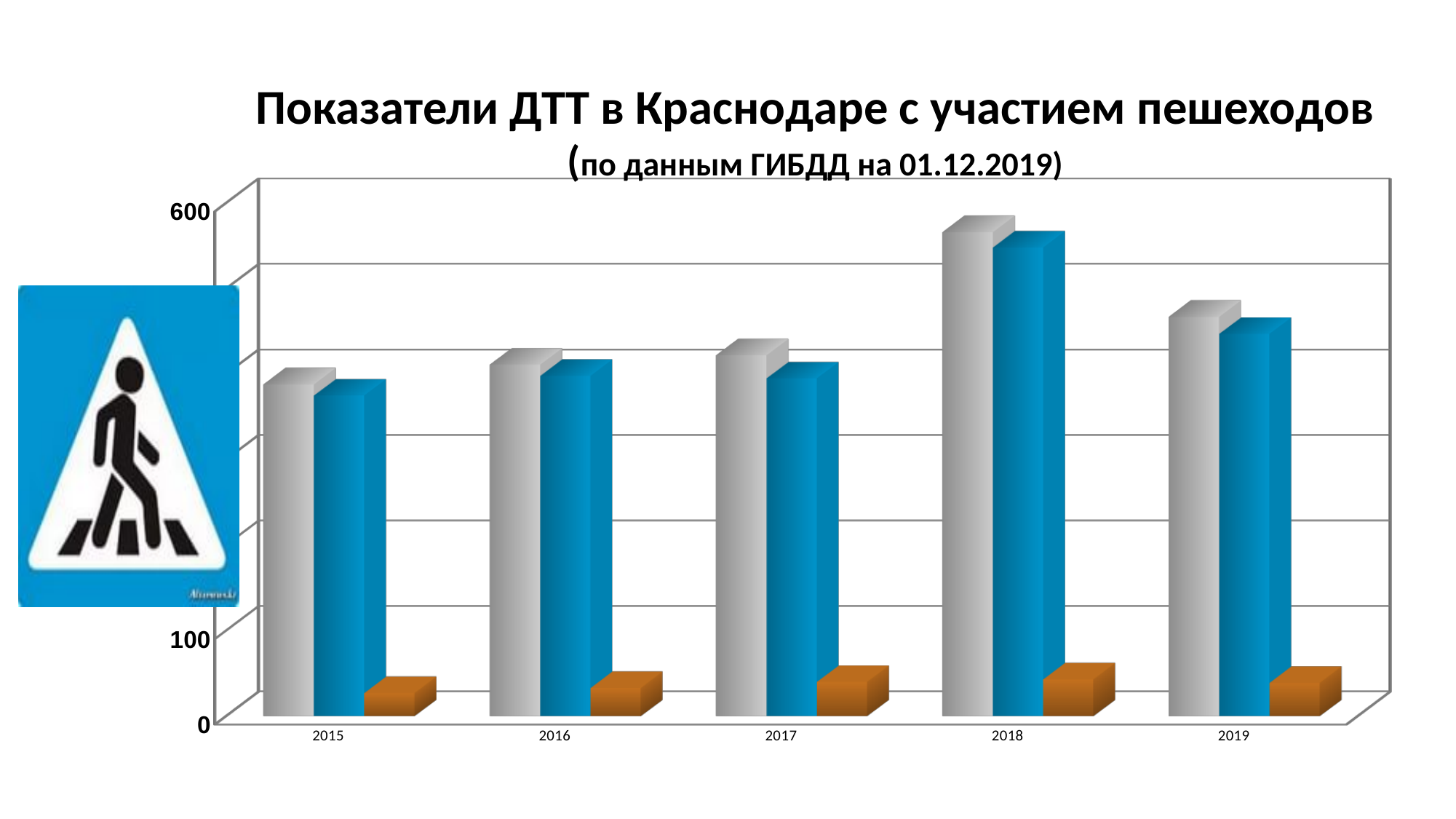
Which is larger, the grey bar for 2018 or the grey bar for 2019? 2018 Is the value of the orange bar for 2019 greater or less than 100? less In which year is the grey bar the shortest? 2015 What is the title of the chart? Показатели ДТТ в Краснодаре с участием пешеходов (по данным ГИБДД на 01.12.2019) How many years are shown on the x axis of the chart? 5 In which year is the grey bar the tallest? 2018 In which year is the blue bar the tallest? 2018 Is the value of the grey bar for 2018 greater or less than 500? greater What kind of chart is shown on the slide? bar chart How many bars are plotted for each year in the chart? 3 Do the grey bars rise or fall from 2015 to 2018? rise